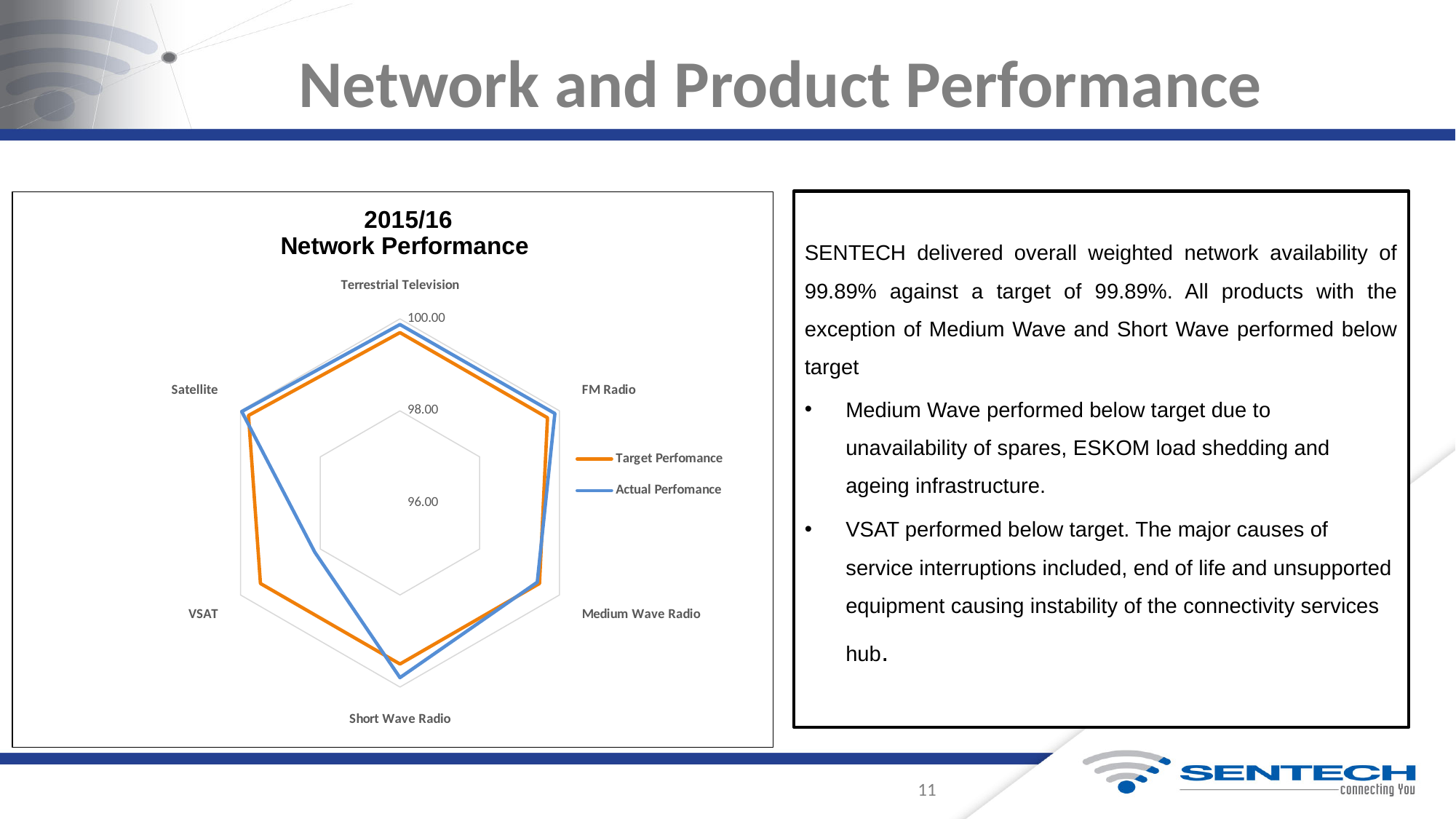
How many categories (axes) does the radar chart have? 6 Which category has the lowest Actual Perfomance value in the chart? VSAT What is the title of the chart? 2015/16 Network Performance What kind of chart is shown on the slide? Radar chart Is the Actual Perfomance value for Medium Wave Radio greater or less than 98.00? greater For VSAT, which is larger: the Target Perfomance or the Actual Perfomance? Target Perfomance Which series is drawn in orange in the chart? Target Perfomance Is the Actual Perfomance value for Terrestrial Television greater or less than 98.00? greater How many series does the legend of the chart list? 2 What is the highest value shown on the chart's axis scale? 100.00 Is the Target Perfomance value for VSAT greater or less than 98.00? greater